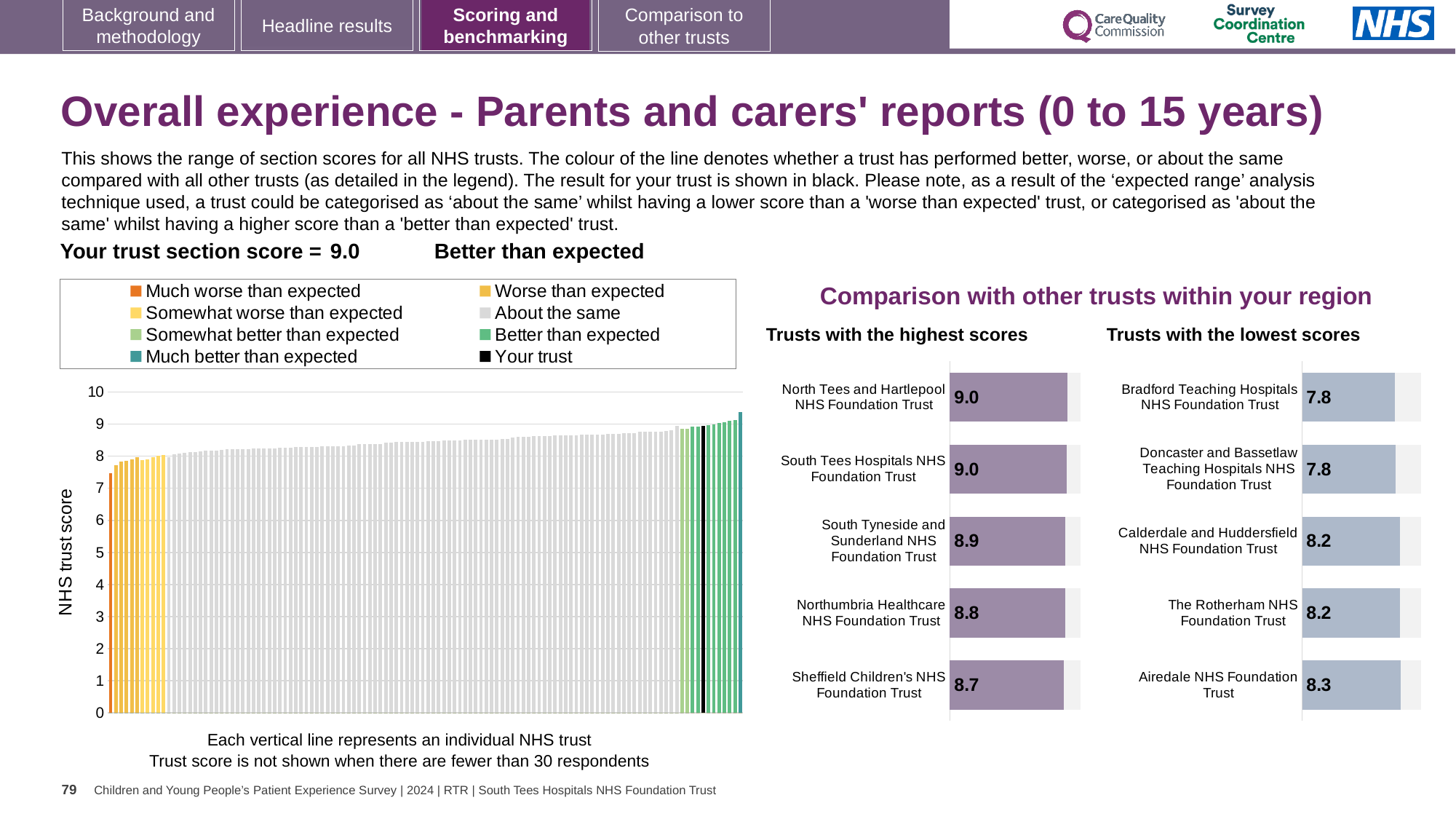
How many entries does the legend of the large NHS trust score chart list? 8 How many trusts are shown in the 'Trusts with the lowest scores' chart? 5 In the 'Trusts with the highest scores' chart, what is the difference between the scores of North Tees and Hartlepool NHS Foundation Trust and Sheffield Children's NHS Foundation Trust? 0.3 In the 'Trusts with the highest scores' chart, what is the score for Northumbria Healthcare NHS Foundation Trust? 8.8 In the large NHS trust score chart on the left, do the bar values rise or fall from left to right? Rise In the 'Trusts with the highest scores' chart, what is the score for Sheffield Children's NHS Foundation Trust? 8.7 In the 'Trusts with the highest scores' chart, which trust has the lowest score? Sheffield Children's NHS Foundation Trust In the 'Trusts with the lowest scores' chart, which has the larger score: Bradford Teaching Hospitals NHS Foundation Trust or The Rotherham NHS Foundation Trust? The Rotherham NHS Foundation Trust What kind of chart is the large chart on the left showing NHS trust scores? Bar chart In the large NHS trust score chart on the left, is the value of the leftmost (orange) bar greater or less than 8? less In the 'Trusts with the lowest scores' chart, which trust has the highest score? Airedale NHS Foundation Trust In the 'Trusts with the lowest scores' chart, what is the score for Calderdale and Huddersfield NHS Foundation Trust? 8.2